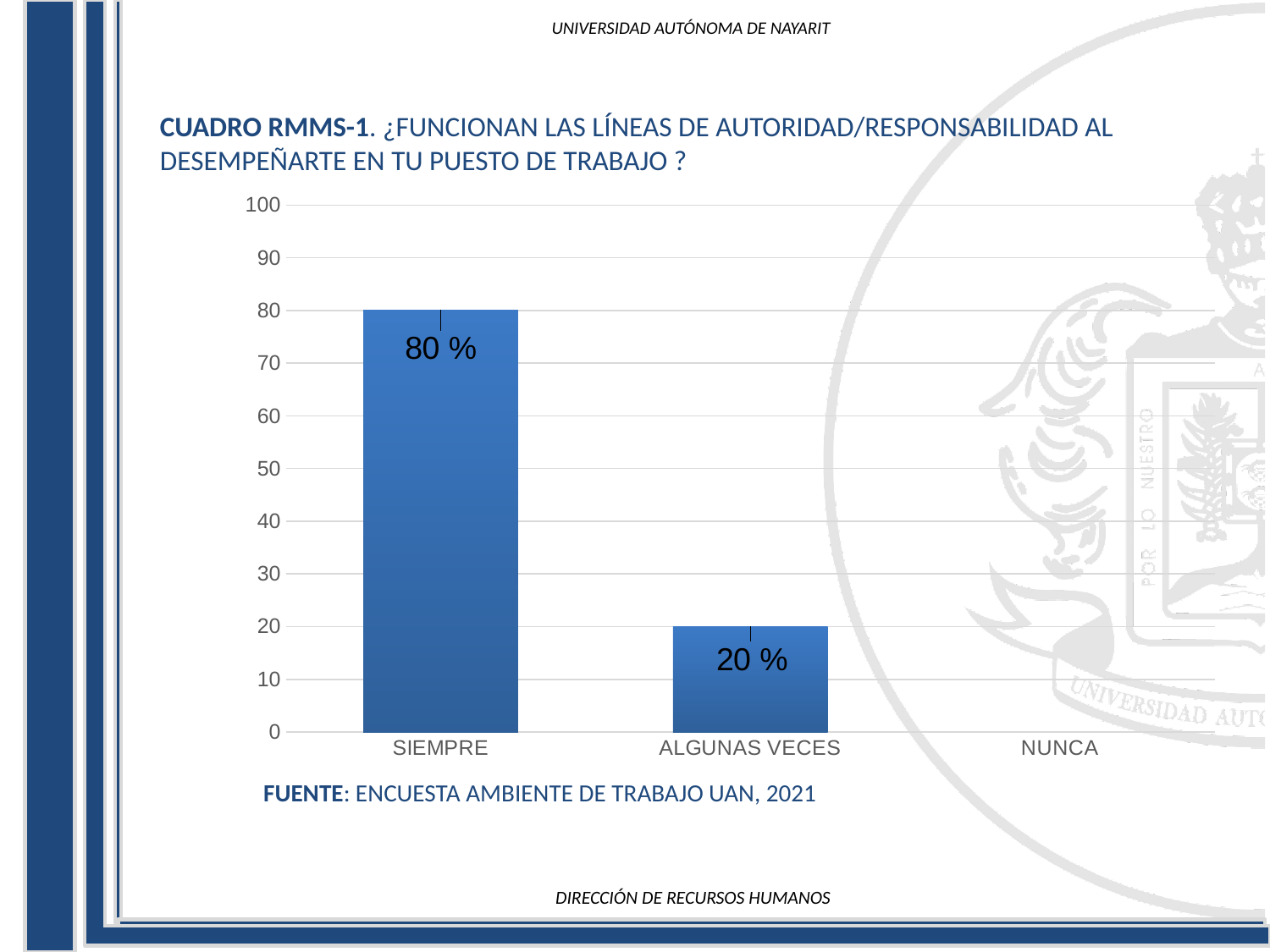
Which is larger, the value for SIEMPRE or the value for ALGUNAS VECES? SIEMPRE Which category has the highest value? SIEMPRE Is the value for SIEMPRE greater or less than 50? greater Is the value for ALGUNAS VECES greater or less than 30? less What kind of chart is shown on the slide? Bar chart What is the value for ALGUNAS VECES? 20 % How many categories are shown on the x axis? 3 What is the difference between the values for SIEMPRE and ALGUNAS VECES? 60 % What is the value for SIEMPRE? 80 % What is the source cited below the chart? ENCUESTA AMBIENTE DE TRABAJO UAN, 2021 Do the values rise or fall from SIEMPRE to NUNCA along the x axis? Fall